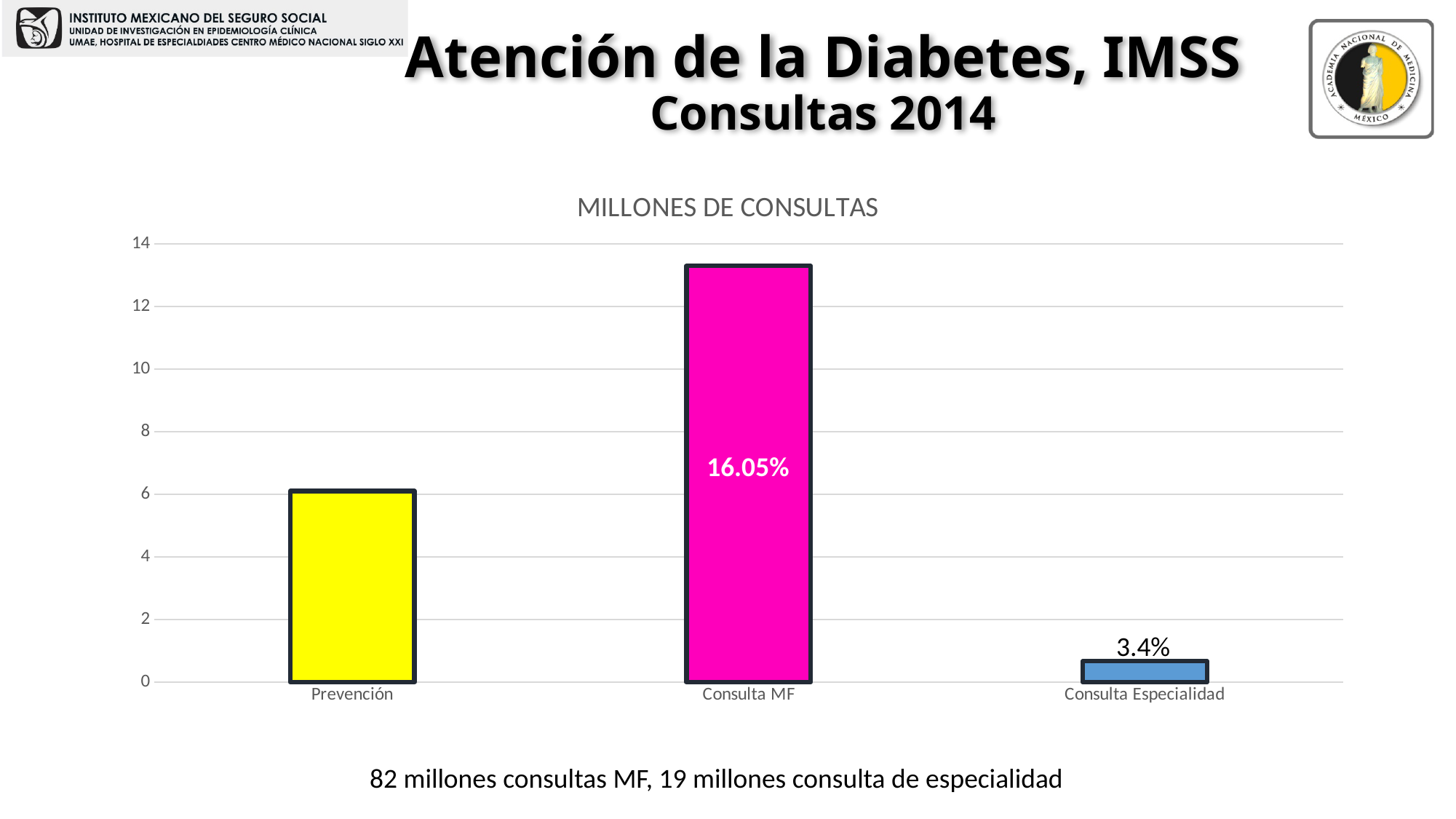
Which is larger, the value for Prevención or the value for Consulta Especialidad? Prevención Is the value for Consulta MF greater or less than 12? greater Which category has the lowest value in the chart? Consulta Especialidad Is the value for Consulta Especialidad greater or less than 2? less Is the value for Prevención greater or less than 4? greater What type of chart is shown on the slide? bar chart What is the title of the chart? MILLONES DE CONSULTAS Which is larger, the value for Consulta MF or the value for Prevención? Consulta MF What percentage label is printed on the Consulta MF bar? 16.05% How many categories are plotted in the chart? 3 Which category has the highest value in the chart? Consulta MF